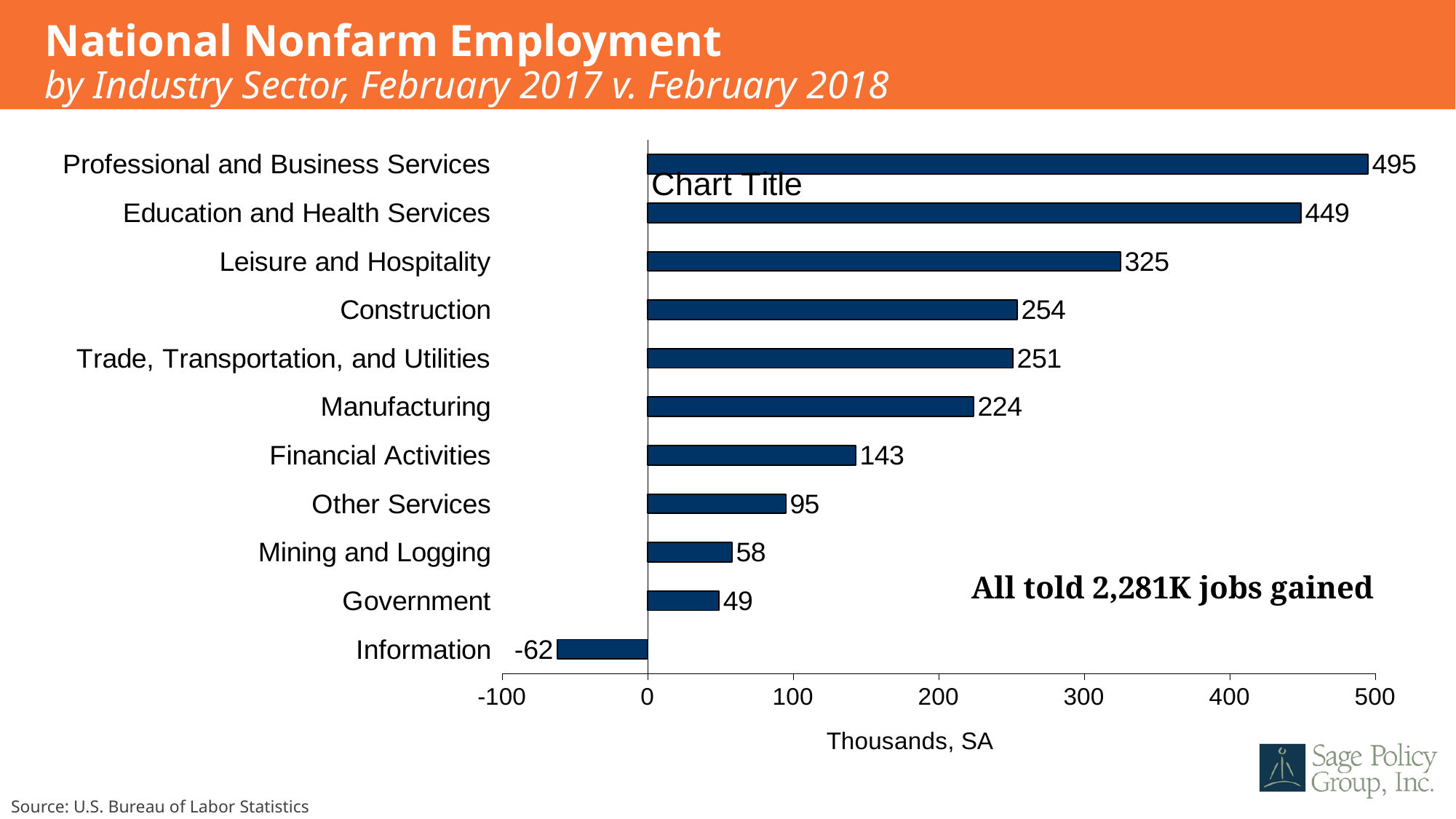
What kind of chart is shown on the slide? bar chart What is the value for Manufacturing? 224 Which industry sector has the lowest value? Information What is the difference between the values for Professional and Business Services and Education and Health Services? 46 What is the value for Professional and Business Services? 495 Which industry sector has the highest value? Professional and Business Services What is the unit label shown on the x axis? Thousands, SA Is the value for Financial Activities greater or less than 100? greater What is the difference between the values for Other Services and Mining and Logging? 37 Which is larger, the value for Leisure and Hospitality or the value for Construction? Leisure and Hospitality How many industry sectors are shown in the chart? 11 What is the value for Information? -62